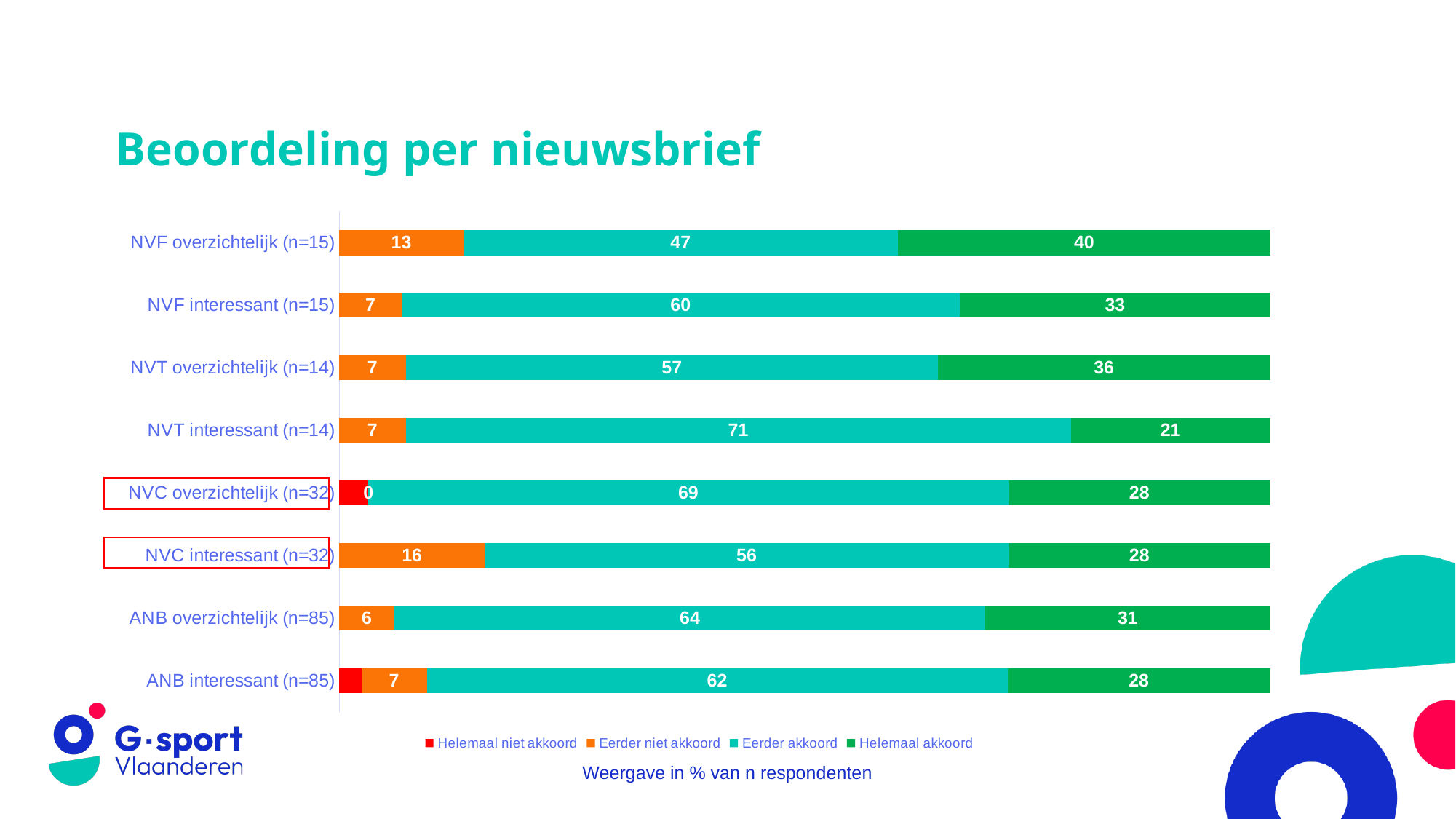
What kind of chart is shown on the slide? Stacked bar chart How many categories (bars) are shown in the chart? 8 Which category has the highest 'Eerder akkoord' value? NVT interessant (n=14) What is the difference between the 'Eerder akkoord' values for NVF interessant (n=15) and NVF overzichtelijk (n=15)? 13 What is the 'Eerder niet akkoord' value for NVC interessant (n=32)? 16 What is the title of the chart? Beoordeling per nieuwsbrief Which is larger: the 'Helemaal akkoord' value for NVT overzichtelijk (n=14) or for ANB overzichtelijk (n=85)? NVT overzichtelijk (n=14) Which legend entry is shown in red? Helemaal niet akkoord How many series does the legend list? 4 What is the 'Eerder akkoord' value for NVT interessant (n=14)? 71 Which category has the lowest 'Helemaal akkoord' value? NVT interessant (n=14) What is the 'Helemaal akkoord' value for NVF overzichtelijk (n=15)? 40